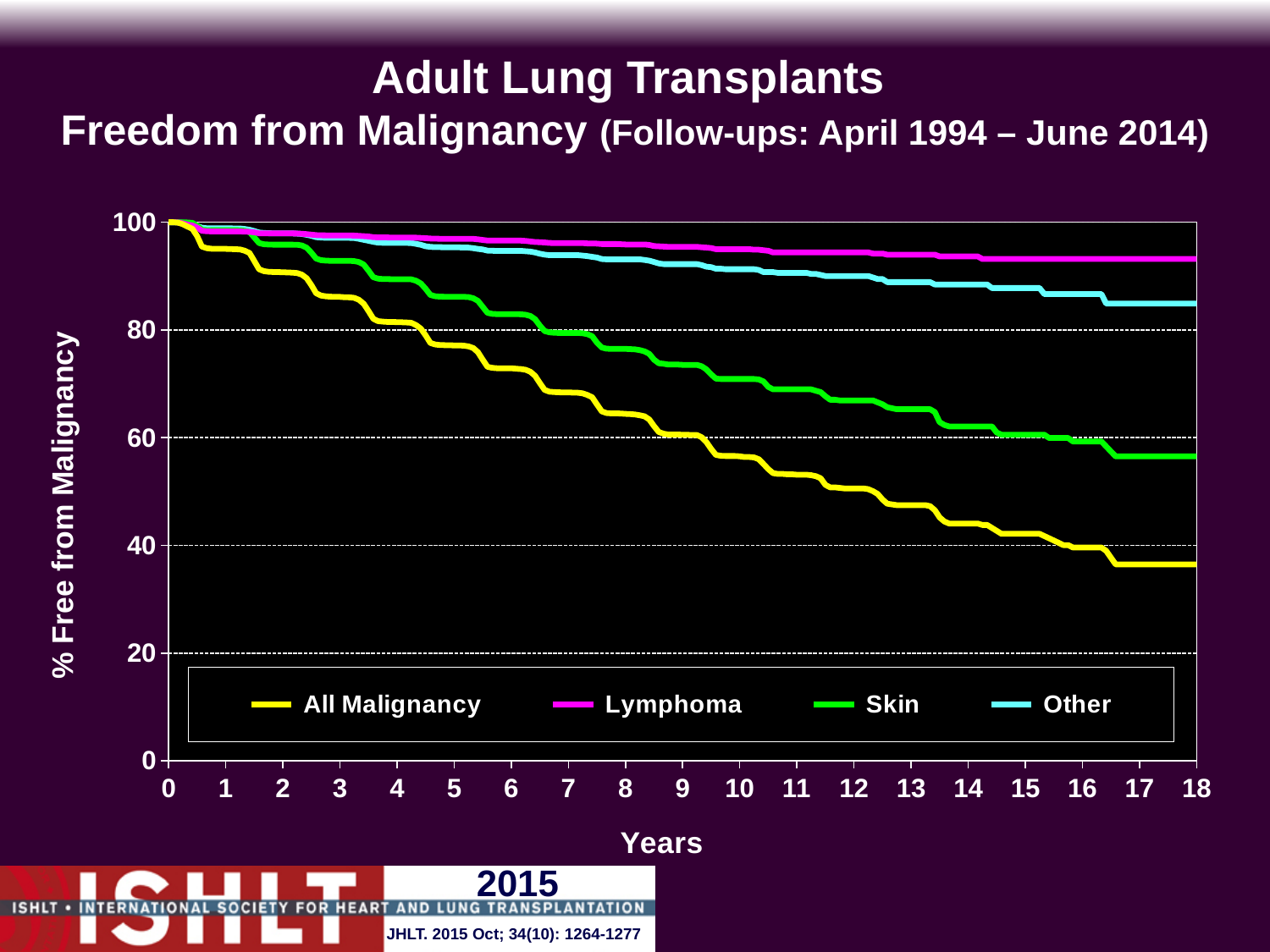
At 10 years, which is higher: Skin or All Malignancy? Skin Is the value for All Malignancy at 10 years greater or less than 60? less Is the value for Other at 18 years greater or less than 80? greater At 18 years, which is higher: Lymphoma or Other? Lymphoma Is the value for All Malignancy at 18 years greater or less than 40? less How many series does the legend list? 4 Which series has the lowest value at 18 years? All Malignancy What kind of chart is shown on the slide? line chart What is the label of the x axis? Years Does the All Malignancy curve rise or fall as the years increase? fall